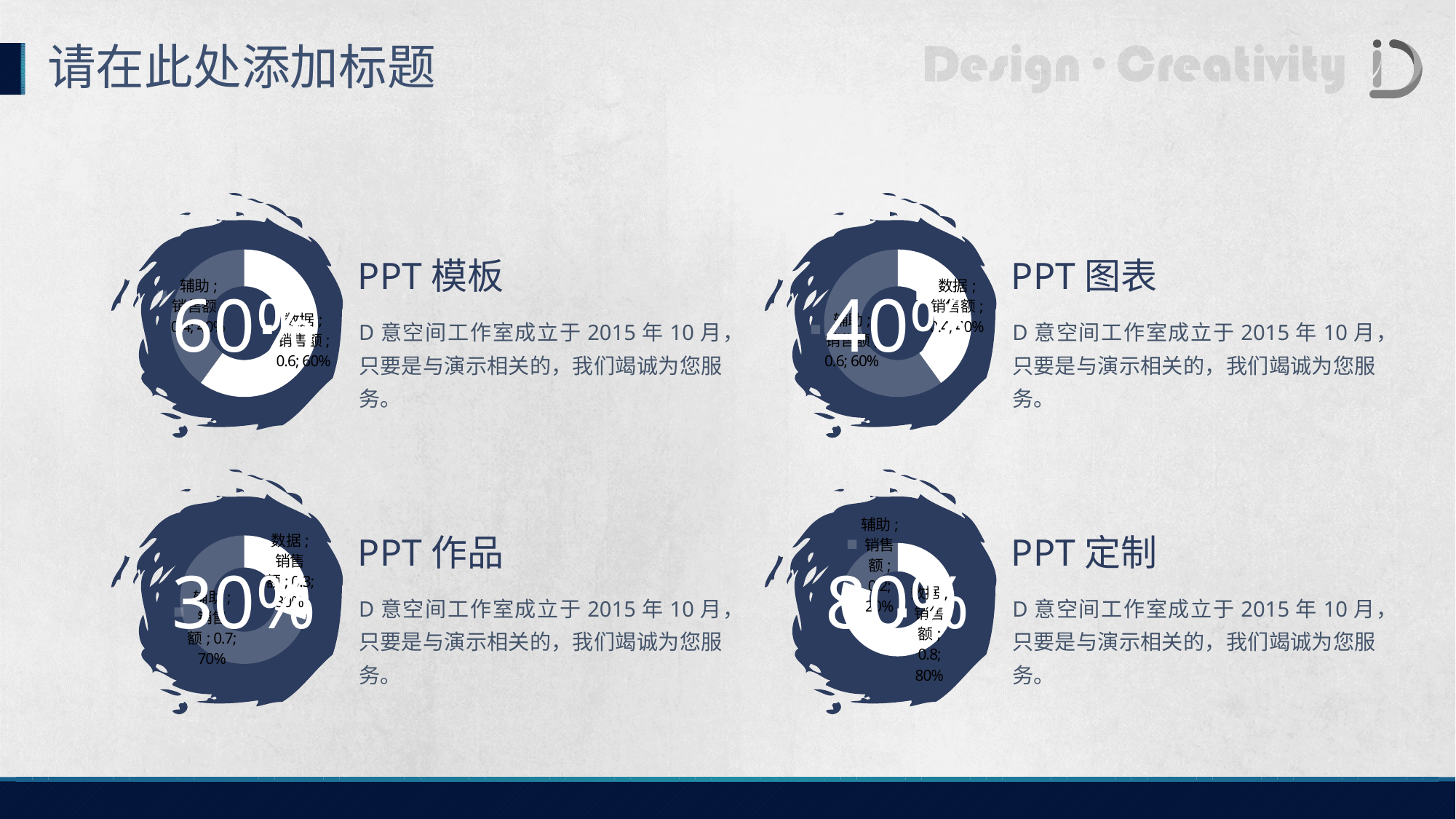
What large percentage is printed over the chart next to PPT 图表 (top-right)? 40% In the bottom-right chart (PPT 定制), what value is shown for the 数据 slice? 0.8 In the top-right chart (PPT 图表), what percentage is shown for the 辅助 slice? 60% How many slices does the doughnut chart next to PPT 定制 (bottom-right) have? 2 What kind of chart is used next to the heading PPT 模板 (top-left)? doughnut chart In the top-left chart (PPT 模板), what percentage is shown for the 数据 slice? 60% In the bottom-left chart (PPT 作品), what percentage is shown for the 数据 slice? 30% How many doughnut charts are on the slide? 4 In the top-left chart (PPT 模板), which slice is the smallest? 辅助 In the bottom-left chart (PPT 作品), which slice is the largest? 辅助 In the bottom-right chart (PPT 定制), what percentage is shown for the 辅助 slice? 20% In the bottom-right chart (PPT 定制), which slice is larger, 数据 or 辅助? 数据